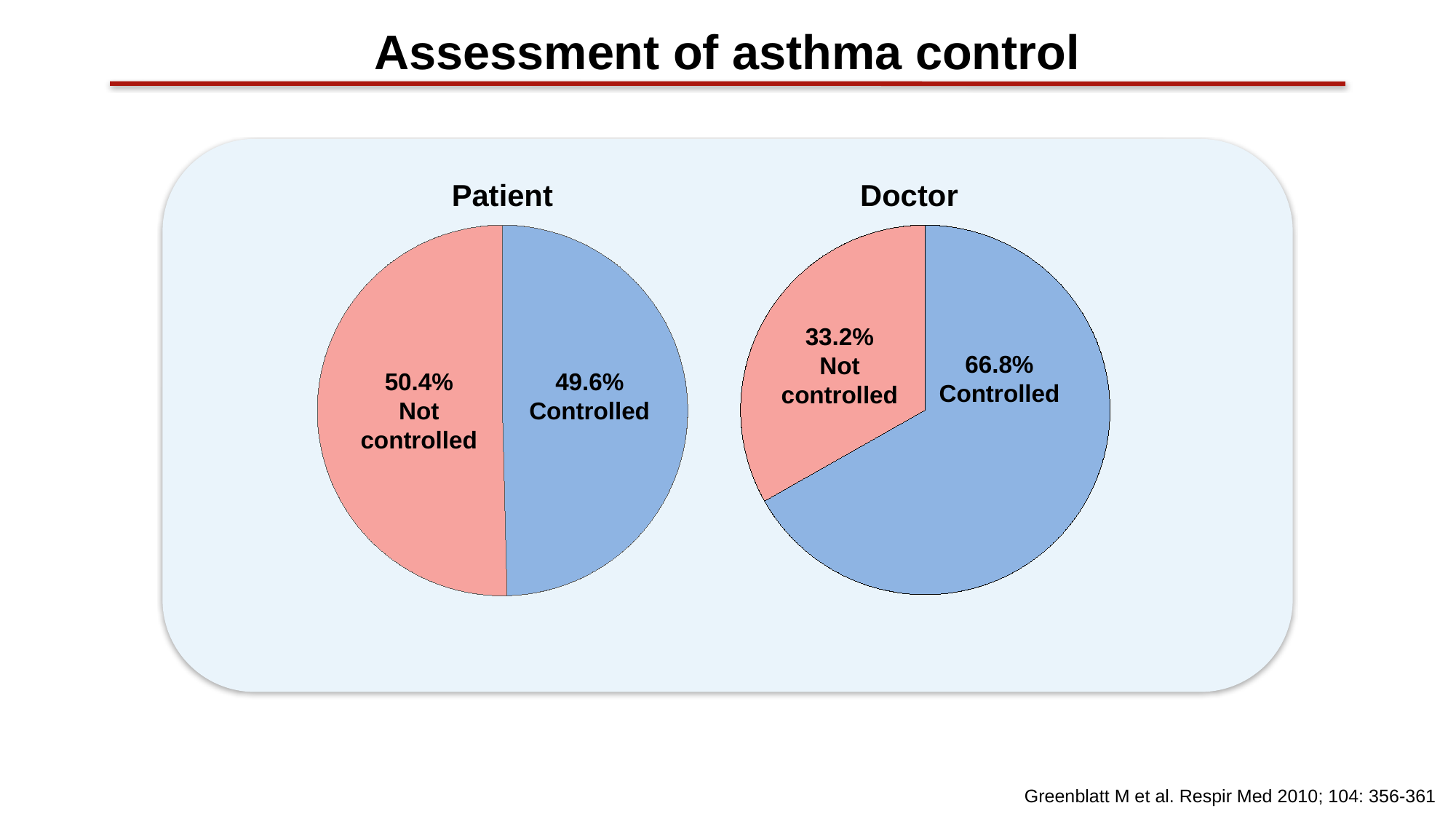
How many slices does the Patient pie chart have? 2 What colour is the Not controlled slice in the Doctor pie chart? Pink How many pie charts are shown on the slide? 2 In the Doctor pie chart, which slice is larger, Controlled or Not controlled? Controlled In the Doctor pie chart, what is the difference between the Controlled and Not controlled percentages? 33.6% In the Patient pie chart, what percentage is labelled Controlled? 49.6% In the Patient pie chart, what percentage is labelled Not controlled? 50.4% In the Doctor pie chart, what percentage is labelled Not controlled? 33.2% What type of chart is used for the Patient and Doctor assessments? Pie chart Which chart shows a higher Controlled percentage, Patient or Doctor? Doctor In the Doctor pie chart, what percentage is labelled Controlled? 66.8% What is the difference between the Controlled percentage in the Doctor chart and the Controlled percentage in the Patient chart? 17.2%